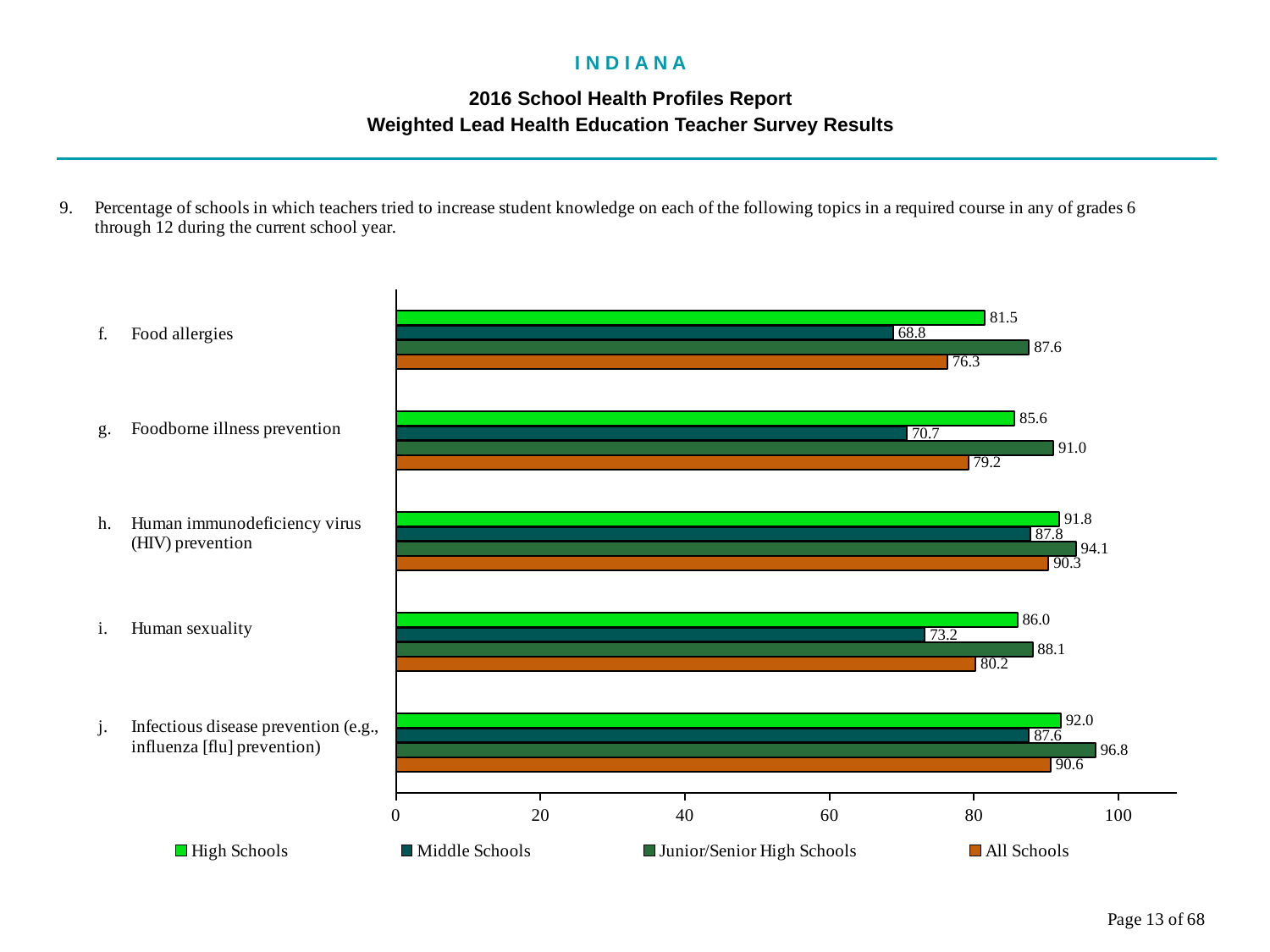
What is the value for Middle Schools for Food allergies? 68.8 Which is larger for Human immunodeficiency virus (HIV) prevention: the High Schools value or the All Schools value? High Schools What is the All Schools value for Human sexuality? 80.2 How many series does the legend list? 4 Which topic has the lowest Middle Schools value? Food allergies Which series is shown in orange in the legend? All Schools What kind of chart is shown on the slide? bar chart What is the value for Junior/Senior High Schools for Infectious disease prevention (e.g., influenza [flu] prevention)? 96.8 Which topic has the highest High Schools value? Infectious disease prevention (e.g., influenza [flu] prevention) How many topics are shown on the chart? 5 Is the Middle Schools value for Human sexuality greater or less than 80? less What is the difference between the Junior/Senior High Schools and Middle Schools values for Foodborne illness prevention? 20.3